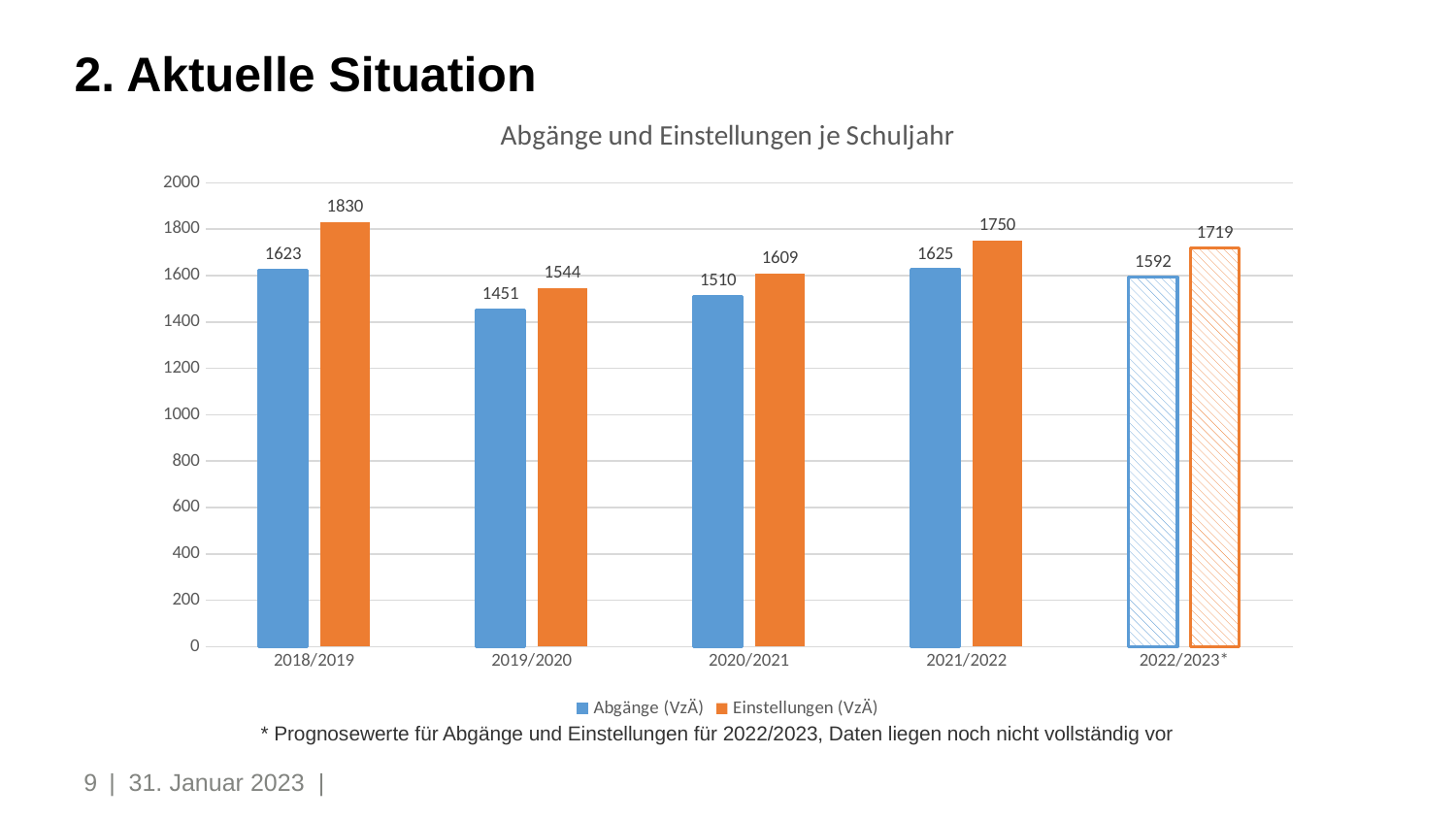
What is the value of Einstellungen (VzÄ) for 2021/2022? 1750 Which school year has the lowest Abgänge (VzÄ) value? 2019/2020 What is the value of Abgänge (VzÄ) for 2018/2019? 1623 How many school years are shown on the x axis? 5 Which is larger in 2020/2021: Abgänge (VzÄ) or Einstellungen (VzÄ)? Einstellungen (VzÄ) Which school year has the highest Einstellungen (VzÄ) value? 2018/2019 What is the title of the chart? Abgänge und Einstellungen je Schuljahr How many series does the legend list? 2 What is the value of Einstellungen (VzÄ) for 2022/2023*? 1719 What is the difference between Einstellungen (VzÄ) and Abgänge (VzÄ) in 2018/2019? 207 What kind of chart is shown on the slide? bar chart Is the value of Abgänge (VzÄ) for 2019/2020 greater or less than 1600? less